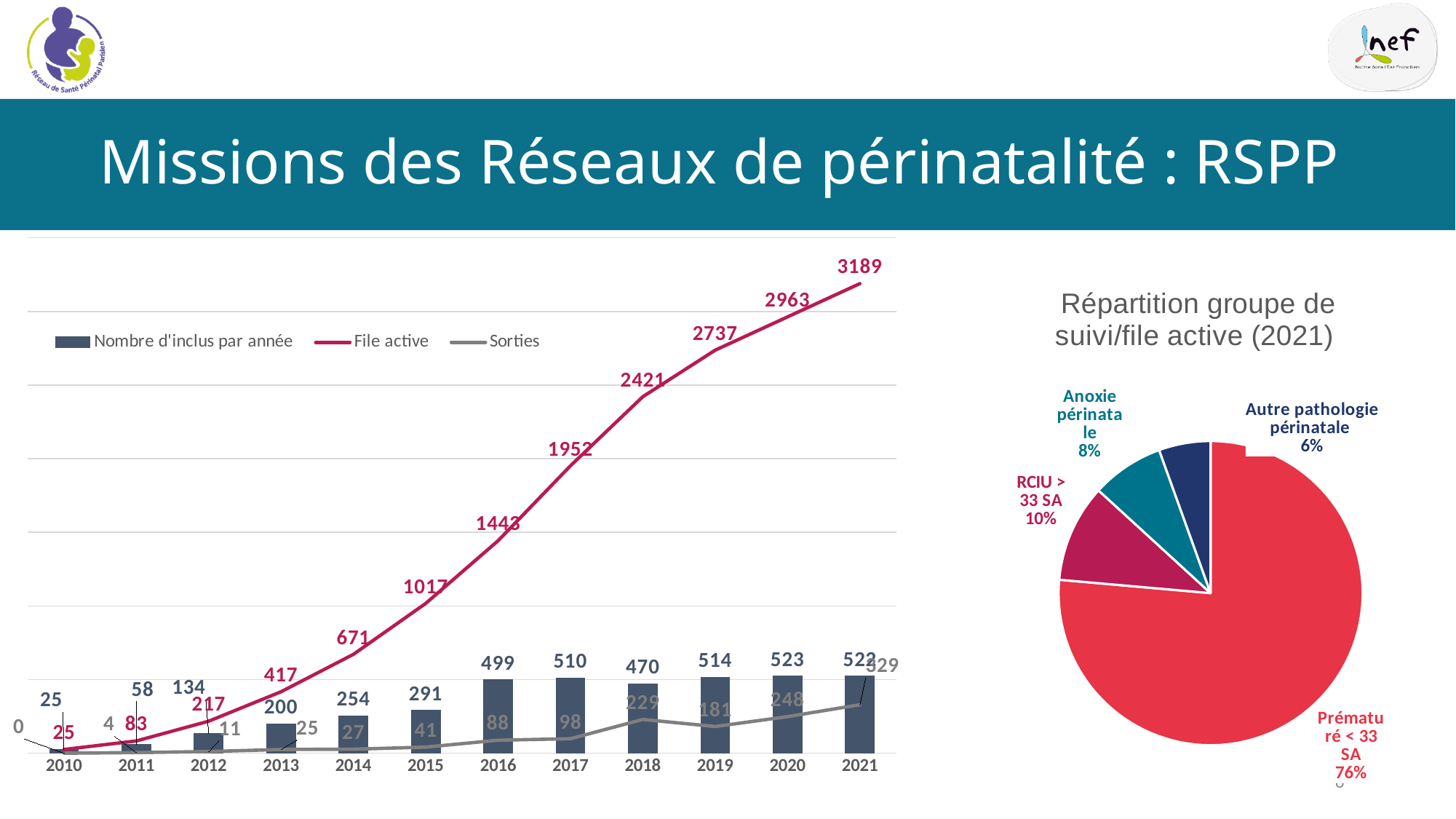
How many series does the legend of the chart on the left list? 3 In the chart on the left, what is the Nombre d'inclus par année for 2017? 510 In the chart on the left, does the File active series rise or fall from 2010 to 2021? rise In the chart on the left, which year has the lowest Nombre d'inclus par année? 2010 In the chart on the left, which is larger: the Sorties value for 2018 or for 2019? 2018 In the chart on the left, what is the difference between the File active values for 2021 and 2020? 226 In the chart on the left, what is the File active value for 2021? 3189 In the chart on the left, what is the Sorties value for 2018? 229 In the chart 'Répartition groupe de suivi/file active (2021)', what share does 'Prématuré < 33 SA' have? 76% How many years are shown on the x axis of the chart on the left? 12 What kind of chart is 'Répartition groupe de suivi/file active (2021)'? pie chart In the chart on the left, which year has the highest Sorties value? 2021